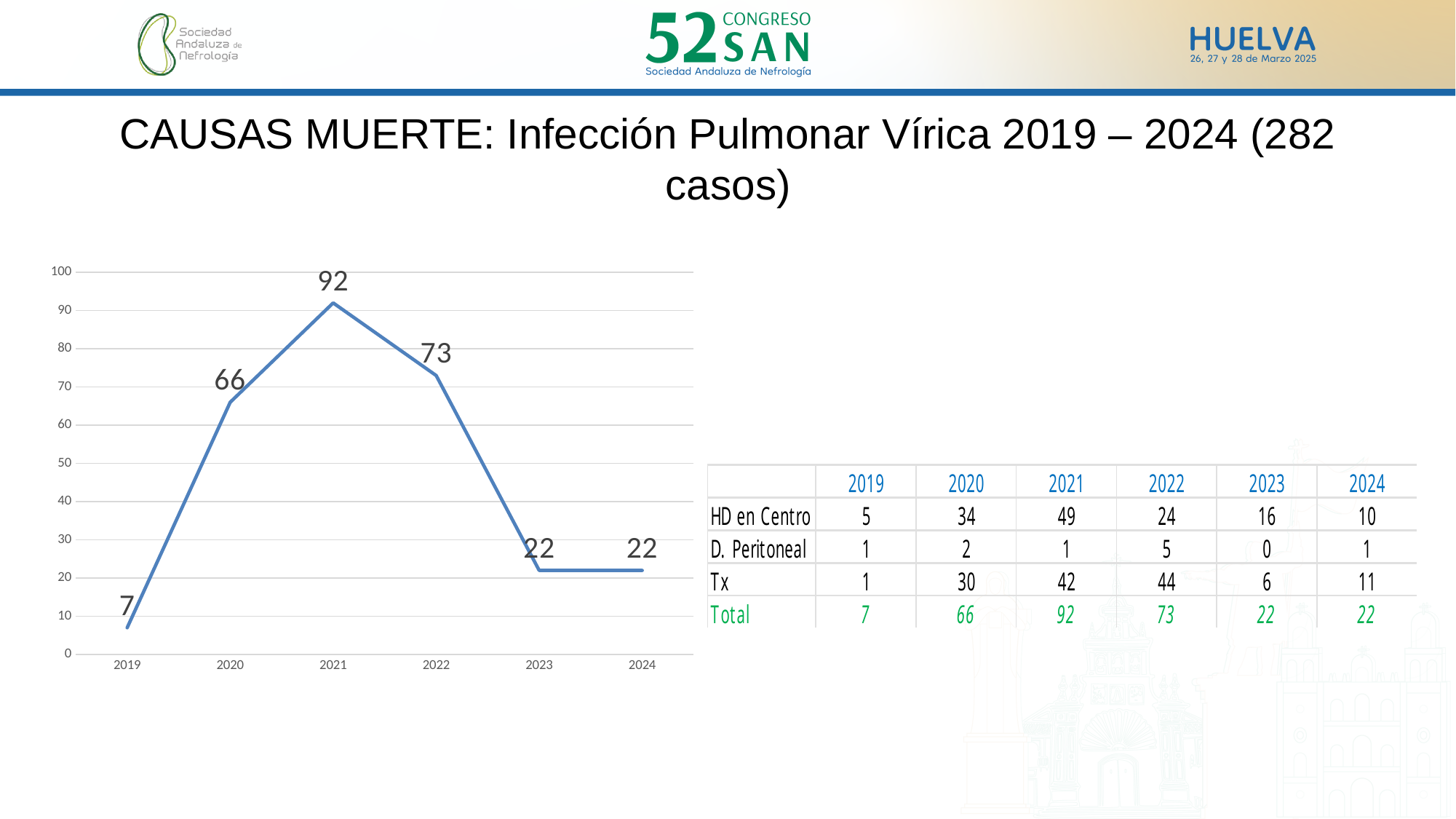
What kind of chart is shown on the slide? line chart Does the value in the line chart rise or fall from 2021 to 2023? fall What is the value plotted for 2021 in the line chart? 92 What is the value plotted for 2019 in the line chart? 7 What is the difference between the values for 2020 and 2019 in the line chart? 59 Which is larger in the line chart, the value for 2020 or the value for 2022? 2022 Which year has the highest value in the line chart? 2021 Is the value for 2023 in the line chart greater or less than 30? less What is the value plotted for 2022 in the line chart? 73 How many years are plotted on the x axis of the line chart? 6 What is the difference between the values for 2021 and 2022 in the line chart? 19 Which year has the lowest value in the line chart? 2019